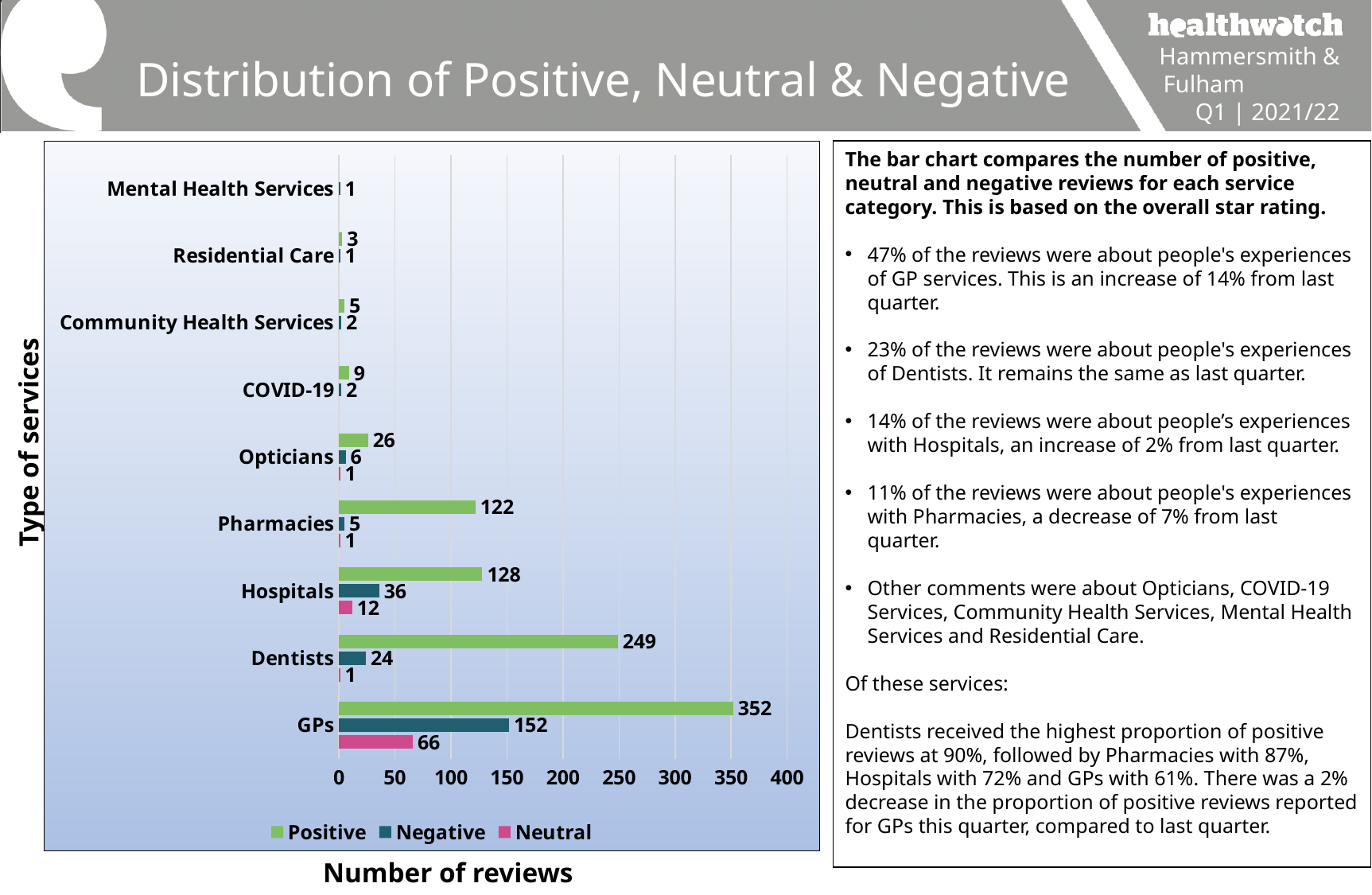
What is the difference between the positive reviews for Hospitals and Pharmacies? 6 What is the number of neutral reviews for GPs? 66 Which has more negative reviews, Dentists or Hospitals? Hospitals What is the number of positive reviews for GPs? 352 What is the label of the x axis? Number of reviews What is the number of positive reviews for Dentists? 249 Which service category has the highest number of positive reviews? GPs What type of chart is shown on the slide? bar chart What is the number of negative reviews for Hospitals? 36 How many series does the legend list? 3 What is the total number of reviews for Hospitals across the three series? 176 How many service categories are shown on the y axis? 9